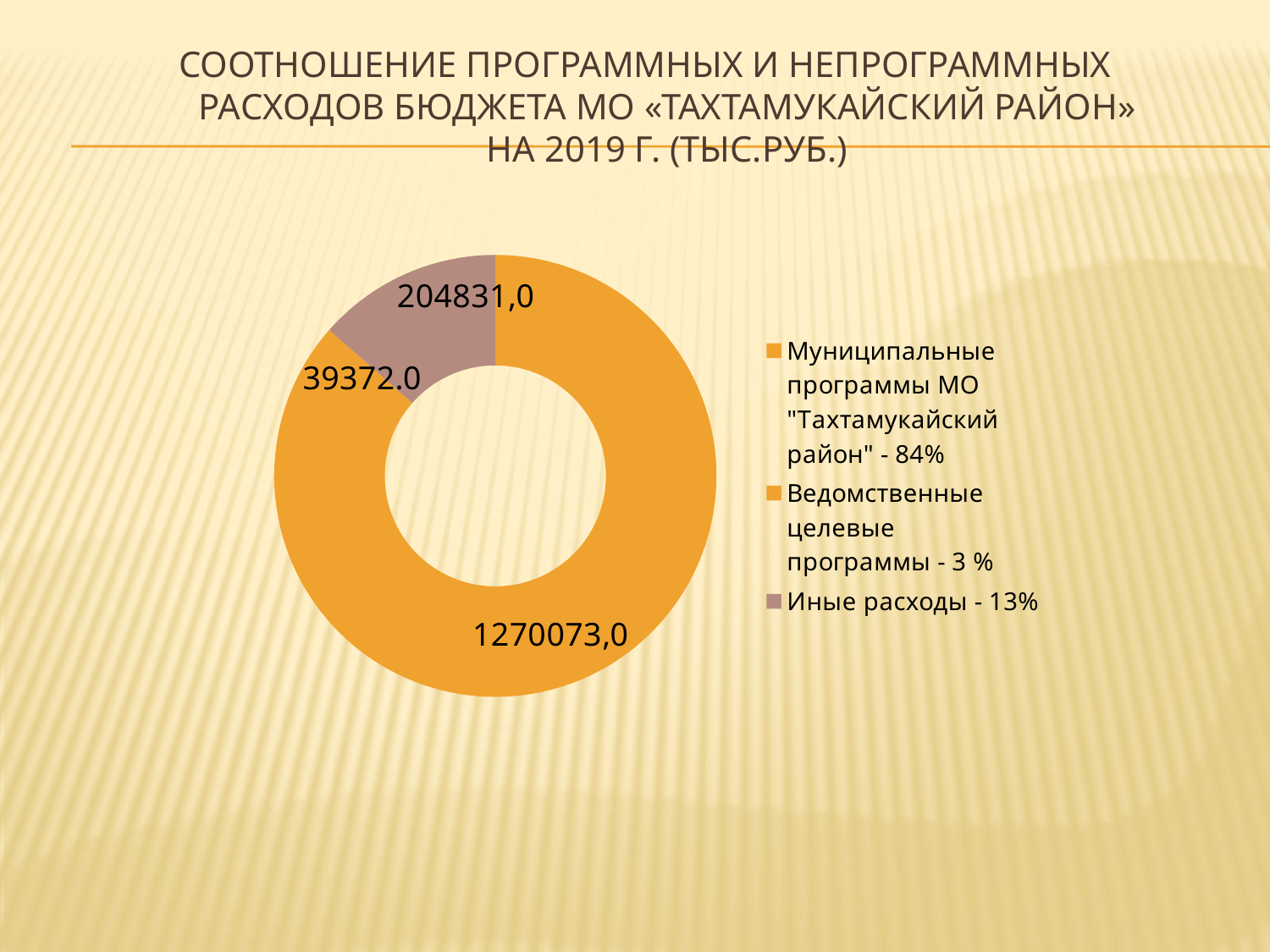
What share of the total do Иные расходы represent? 13% What is the value for Иные расходы? 204831,0 What share of the total do Муниципальные программы МО "Тахтамукайский район" represent? 84% How many entries does the legend list? 3 Which category has the largest value? Муниципальные программы МО "Тахтамукайский район" What is the difference between the value for Иные расходы and the value for Ведомственные целевые программы? 165459,0 What kind of chart is shown on the slide? Doughnut (pie) chart How many slices does the chart have? 3 What is the value for Ведомственные целевые программы? 39372.0 Which category has the smallest value? Ведомственные целевые программы What is the value for Муниципальные программы МО "Тахтамукайский район"? 1270073,0 Which is larger: Иные расходы or Ведомственные целевые программы? Иные расходы